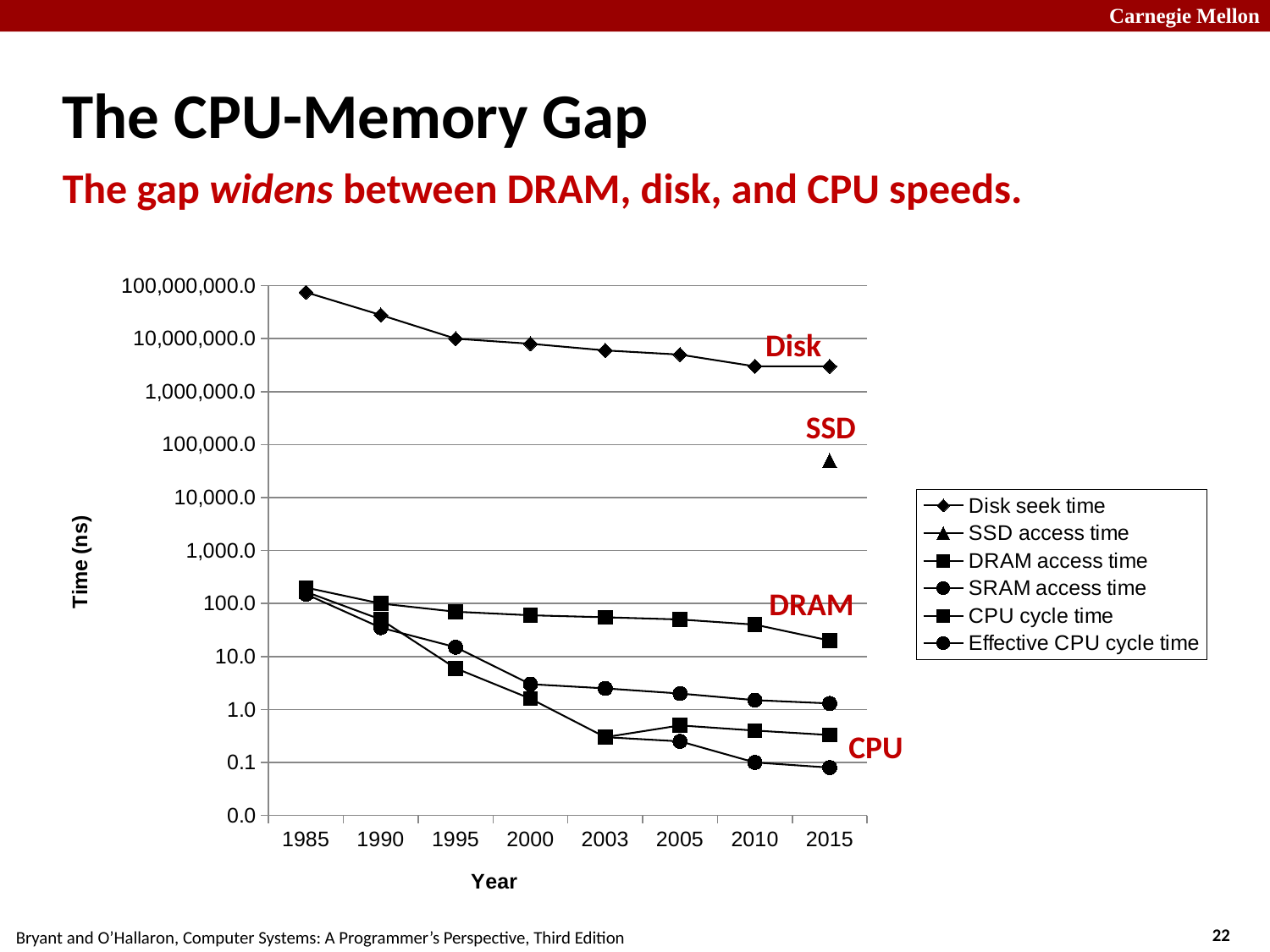
How many series does the legend list? 6 What kind of chart is shown on the slide? line chart Is the DRAM access time in 2015 greater or less than 100.0? less Is the Disk seek time in 2015 greater or less than 10,000,000.0? less Which series has the lowest value in 2015? Effective CPU cycle time How many years are plotted along the x axis? 8 Which series has the highest value in 2015? Disk seek time What is the label of the y axis? Time (ns) Which is larger in 2015, Disk seek time or DRAM access time? Disk seek time Is the SSD access time in 2015 greater or less than 100,000.0? less Does the Disk seek time rise or fall from 1985 to 2015? fall